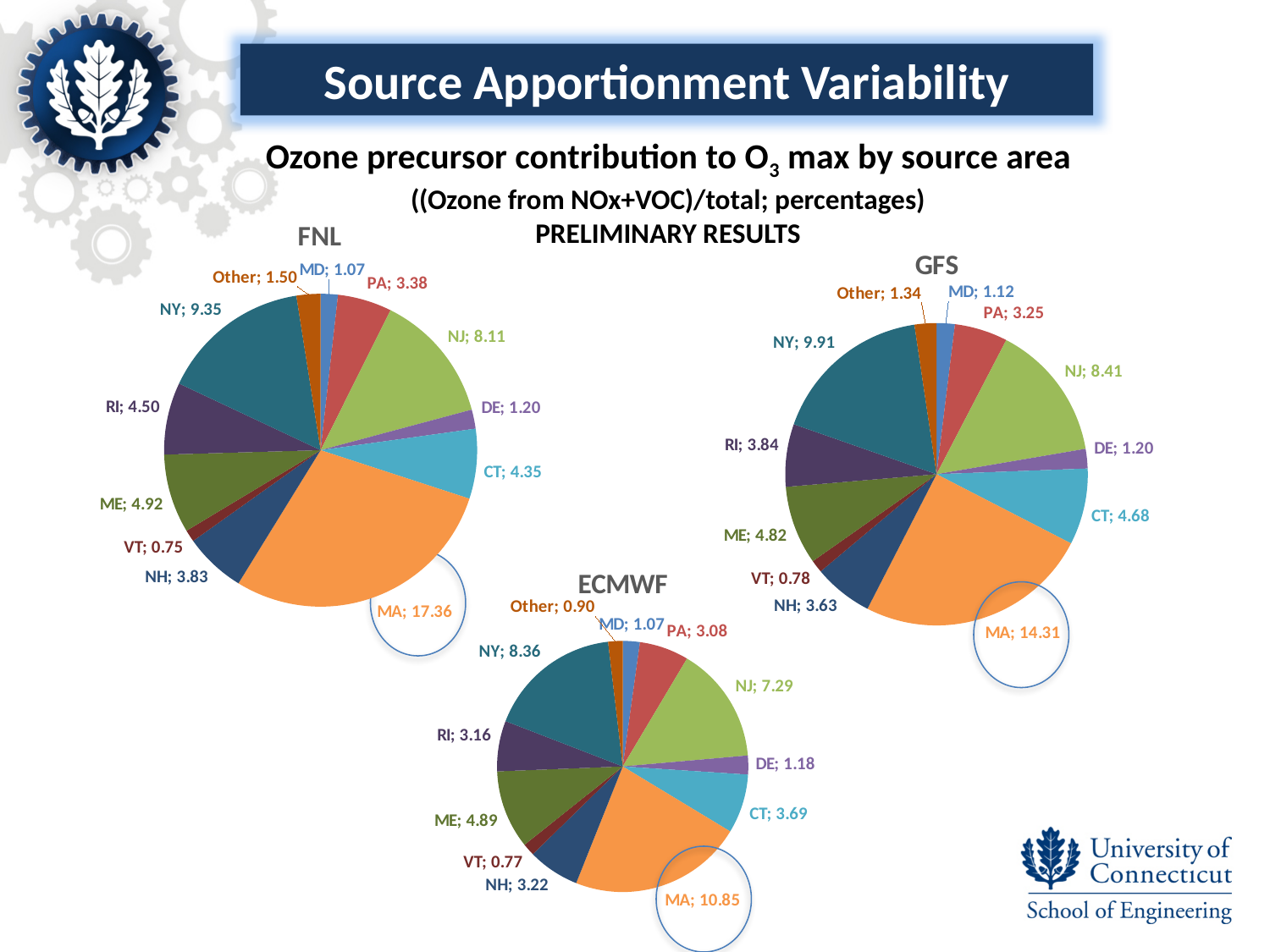
What is the difference between the MA value in the FNL chart and the MA value in the GFS chart? 3.05 In the GFS pie chart, what is the value for RI? 3.84 In the FNL pie chart, what is the value for MA? 17.36 In the ECMWF pie chart, which source area has the smallest slice? VT In the GFS pie chart, what is the value for NY? 9.91 In the GFS pie chart, which source area has the largest slice? MA What kind of chart is used to show the FNL results? Pie chart What are the titles of the three pie charts on the slide? FNL, GFS, ECMWF In the ECMWF pie chart, what is the value for NJ? 7.29 How many slices does the ECMWF pie chart have? 12 In the FNL pie chart, which is larger, the value for NY or the value for NJ? NY Which chart has the larger value for CT, GFS or ECMWF? GFS